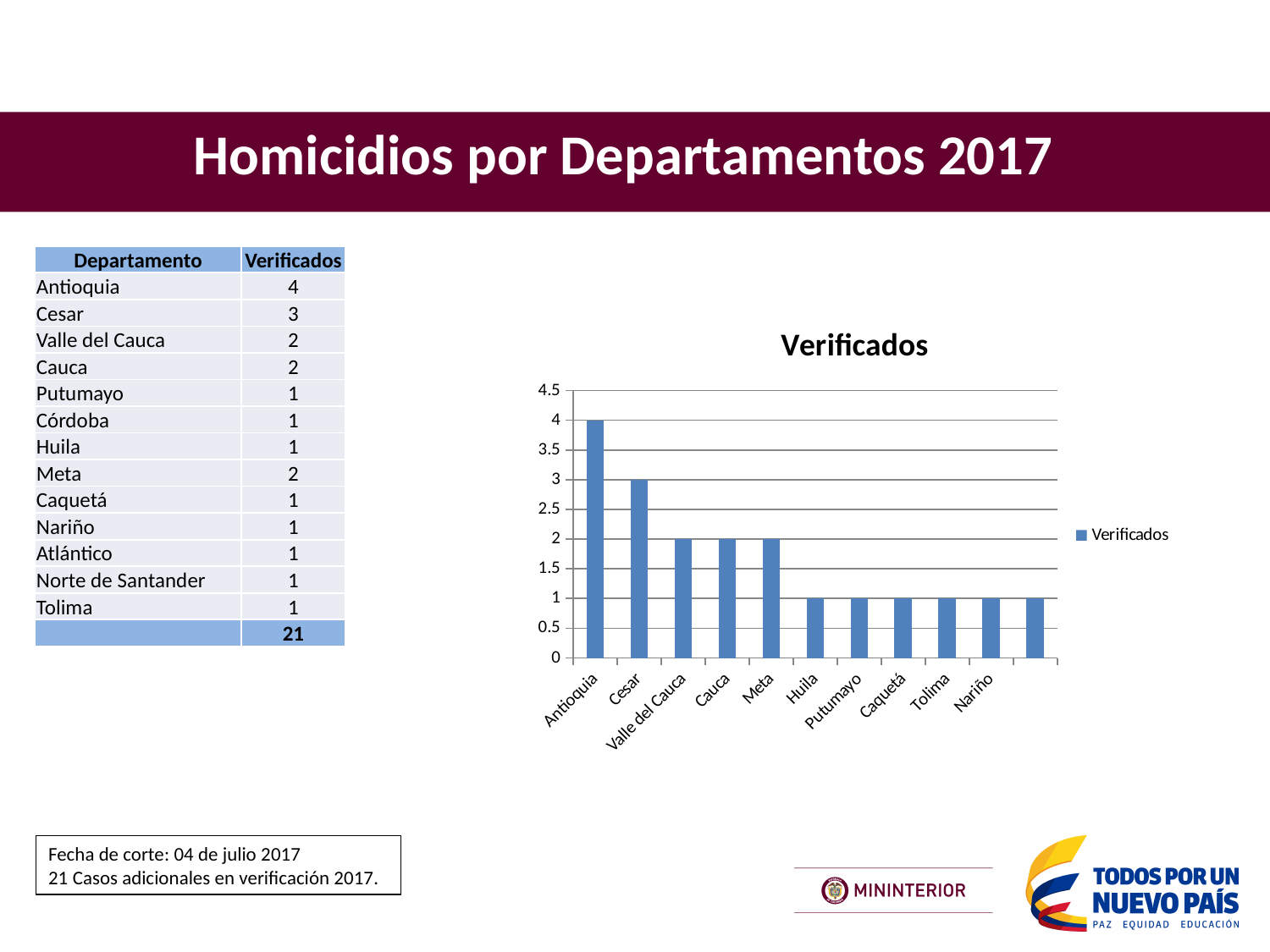
What is the value for Meta in the chart? 2 What is the value for Huila in the chart? 1 What is the value for Cesar in the chart? 3 What is the value for Antioquia in the chart? 4 Which is larger, the value for Cesar or the value for Cauca? Cesar What type of chart is shown on the slide? bar chart Which category has the highest value in the chart? Antioquia What is the title of the chart? Verificados What is the difference between the values for Antioquia and Cesar? 1 Is the value for Antioquia greater or less than 3.5? greater How many series does the chart legend list? 1 Do the values generally rise or fall from left to right along the x axis? fall